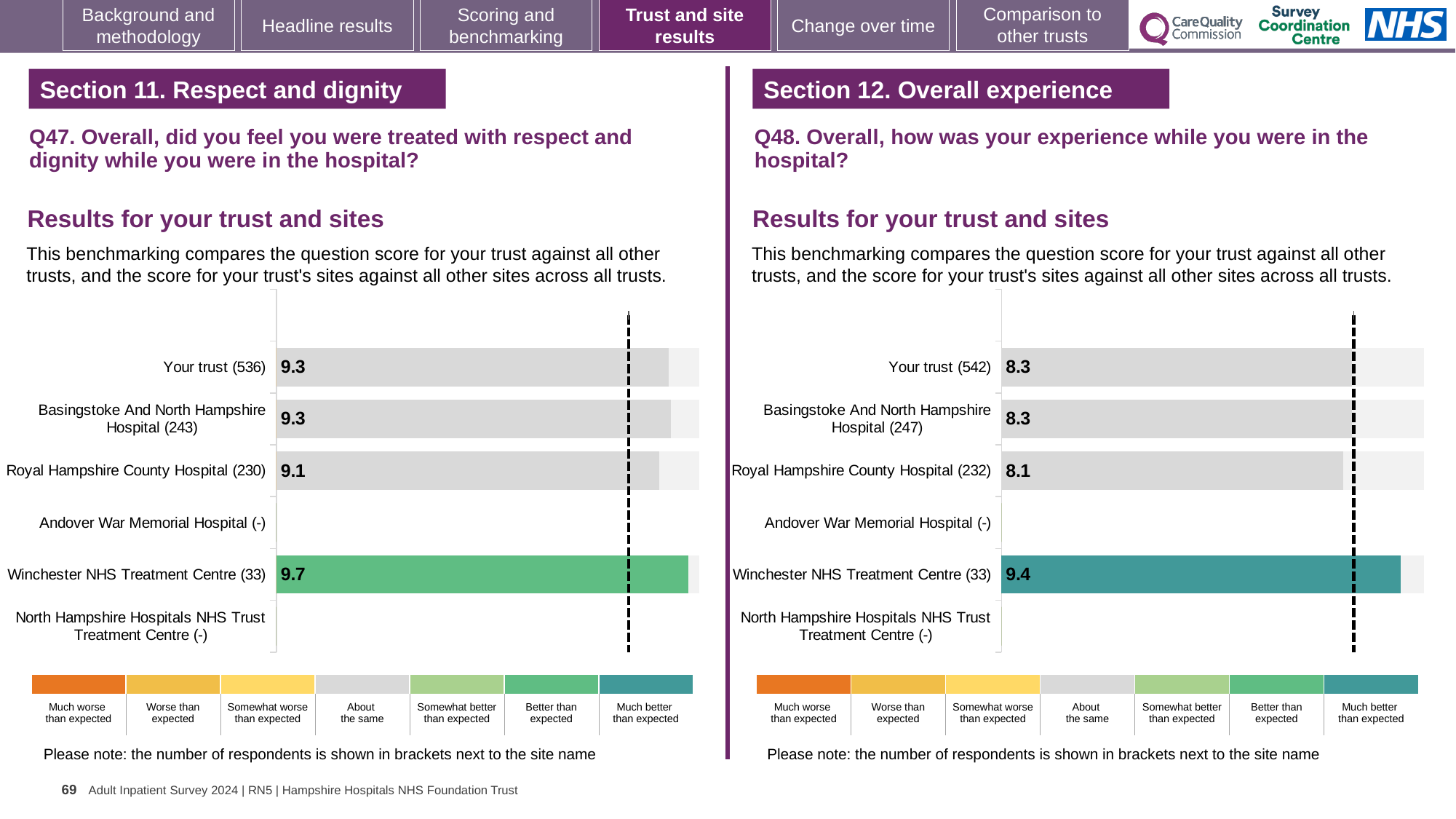
What kind of chart is used for the Q48 results on the right? Bar chart In the Q47 chart on the left, what is the score for Your trust (536)? 9.3 In the Q47 chart on the left, what is the score for Royal Hampshire County Hospital (230)? 9.1 In the Q47 chart on the left, which site has the highest score? Winchester NHS Treatment Centre (33) In the Q48 chart on the right, what is the score for Winchester NHS Treatment Centre (33)? 9.4 In the Q48 chart on the right, which site with a score shown has the lowest score? Royal Hampshire County Hospital (232) Which is larger: the Q47 score for Basingstoke And North Hampshire Hospital (243) on the left chart or the Q48 score for Basingstoke And North Hampshire Hospital (247) on the right chart? Q47 score (9.3) In the Q48 chart on the right, what is the score for Your trust (542)? 8.3 In the Q47 chart on the left, what is the difference between the scores for Winchester NHS Treatment Centre (33) and Royal Hampshire County Hospital (230)? 0.6 In the Q48 chart on the right, what is the difference between the scores for Winchester NHS Treatment Centre (33) and Your trust (542)? 1.1 In the Q48 chart on the right, which benchmark category does the colour of the Winchester NHS Treatment Centre (33) bar correspond to in the legend? Much better than expected How many site/trust categories are listed on the Q47 chart on the left? 6